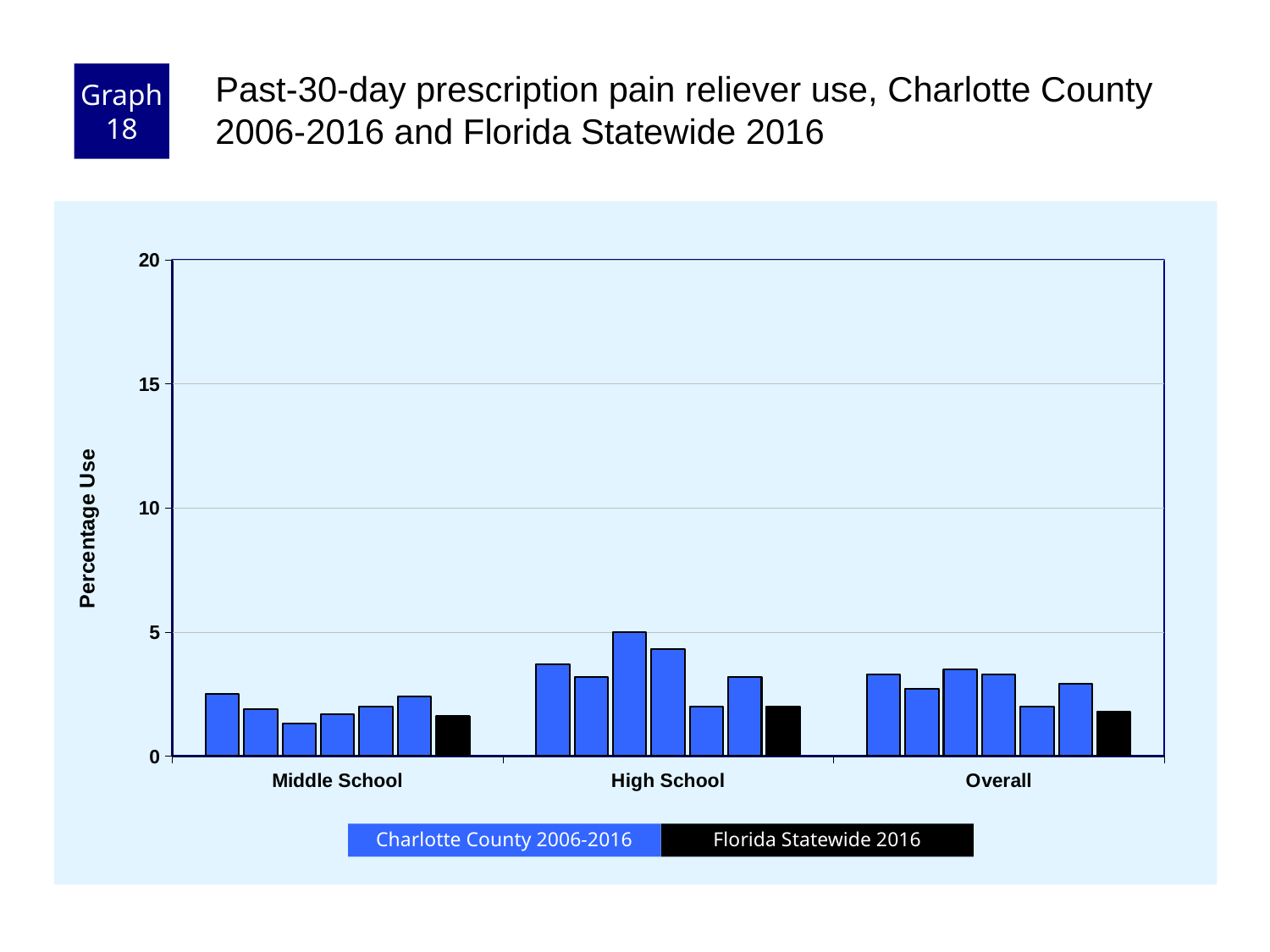
What kind of chart is shown on the slide? bar chart How many series does the legend list? 2 Is the Florida Statewide 2016 value for Overall greater or less than 5? less Is the Florida Statewide 2016 value for Middle School greater or less than 5? less Which category contains the tallest bar on the chart? High School Are all the Middle School bars greater or less than 5? less How many categories are shown along the x axis? 3 Which is larger: the tallest Charlotte County bar for High School or the tallest Charlotte County bar for Middle School? High School Which category contains the shortest bar on the chart? Middle School What is the label on the y axis? Percentage Use Which colour represents Florida Statewide 2016 in the legend? black